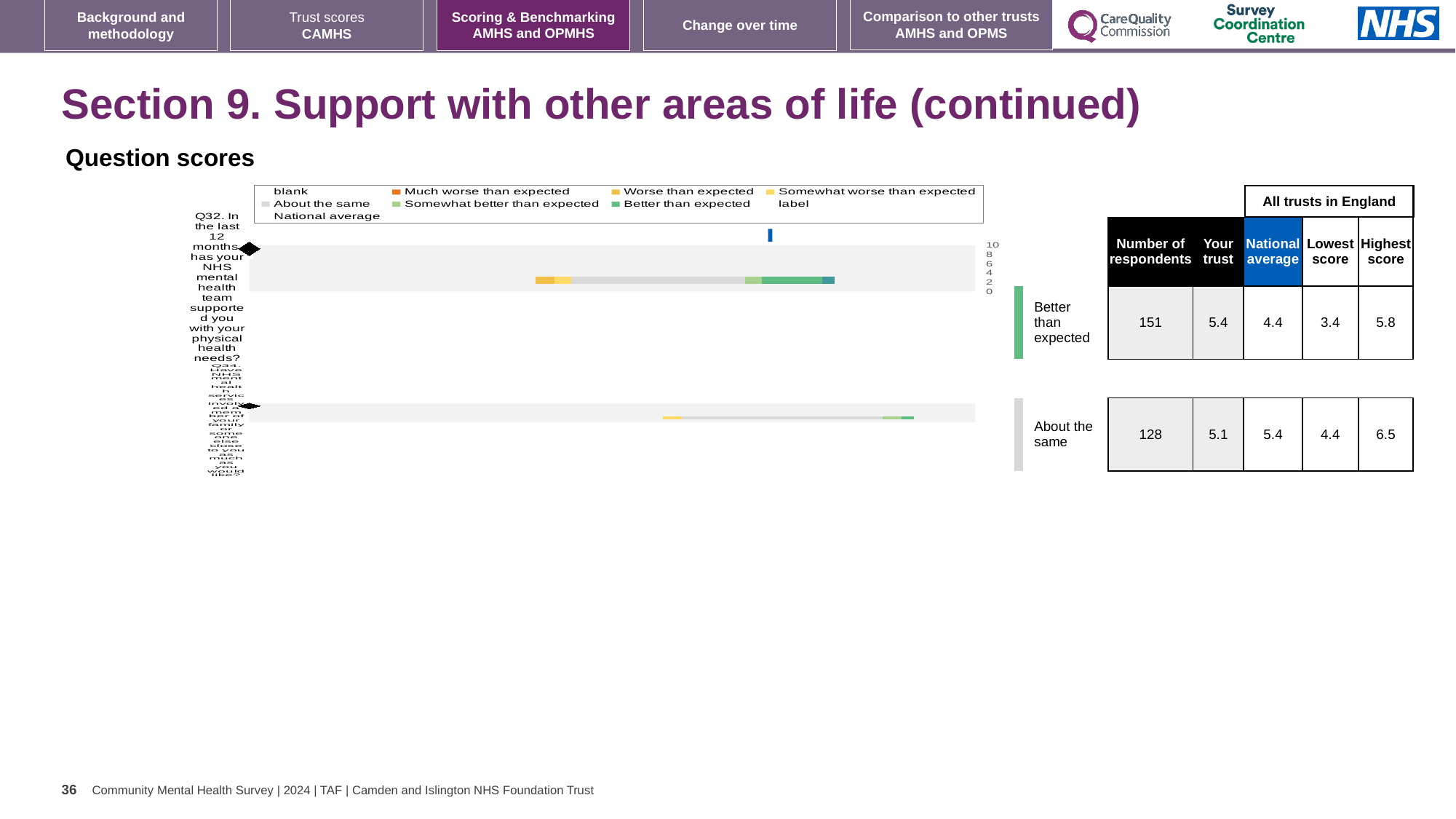
How many questions are plotted in the question scores chart? 2 For Q32, which is larger: the 'Your trust' score or the national average? Your trust How many more respondents answered Q32 than Q34? 23 Which question in the chart is labelled 'Better than expected'? Q32 In the table beside the chart, what is the highest score for Q34? 6.5 For Q34, which is larger: the 'Your trust' score or the national average? National average In the table beside the chart, how many respondents are listed for Q32? 151 In the table beside the chart, what is the national average for Q34? 5.4 What kind of chart is used to show the question scores on this slide? Bar chart In the table beside the chart, what is the 'Your trust' score for Q32? 5.4 What is the difference between the highest score and the lowest score for Q32? 2.4 What label is given to Q34 in the chart? About the same